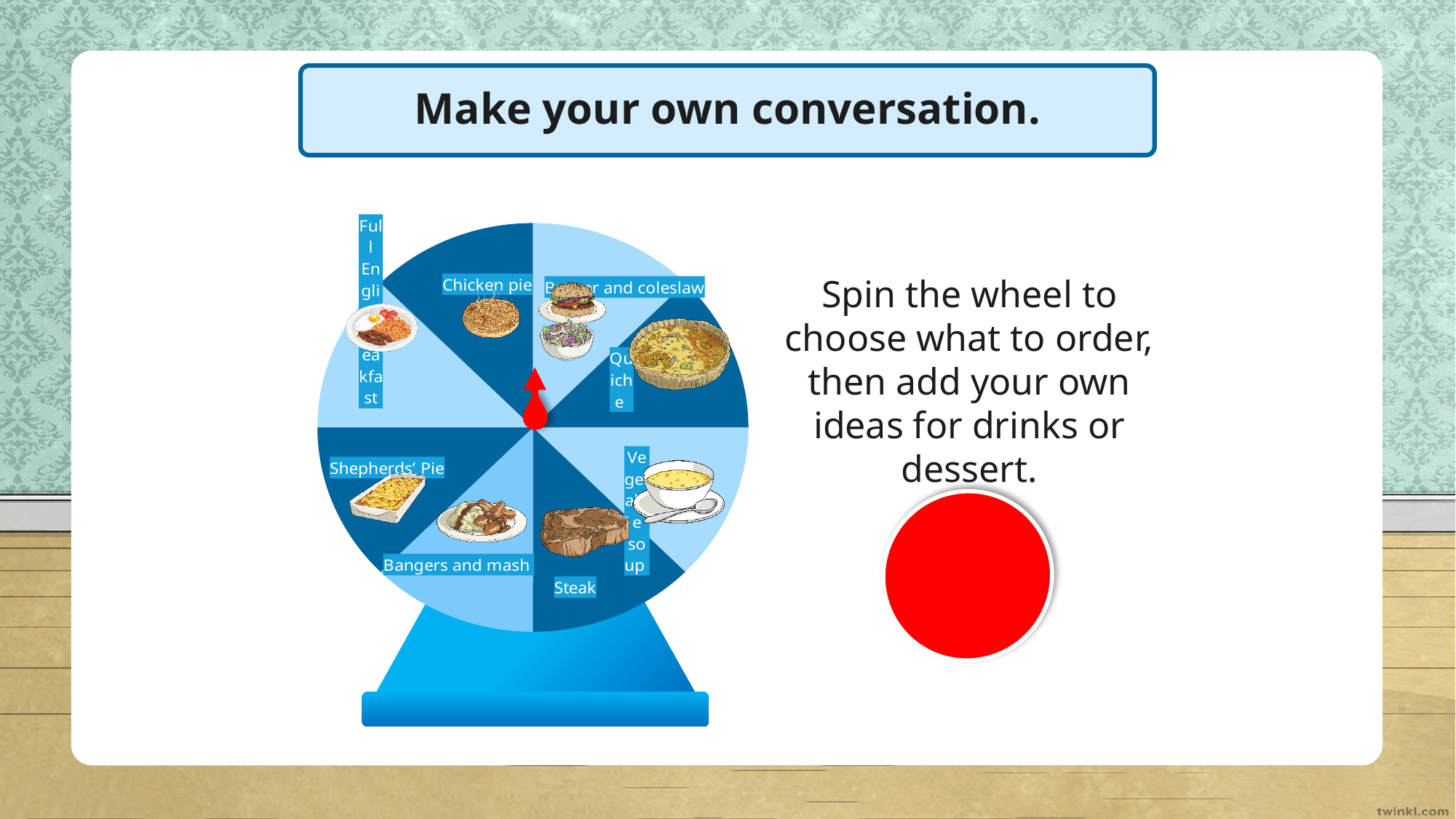
Are the slices of the wheel all the same size? yes Which meal label appears at the bottom of the wheel, next to the picture of meat? Steak What kind of chart is the wheel on the slide? pie chart Which meal is labelled in the slice directly below 'Chicken pie' on the wheel? Shepherds' Pie How many different meals are listed on the wheel? 8 How many slices does the wheel have? 8